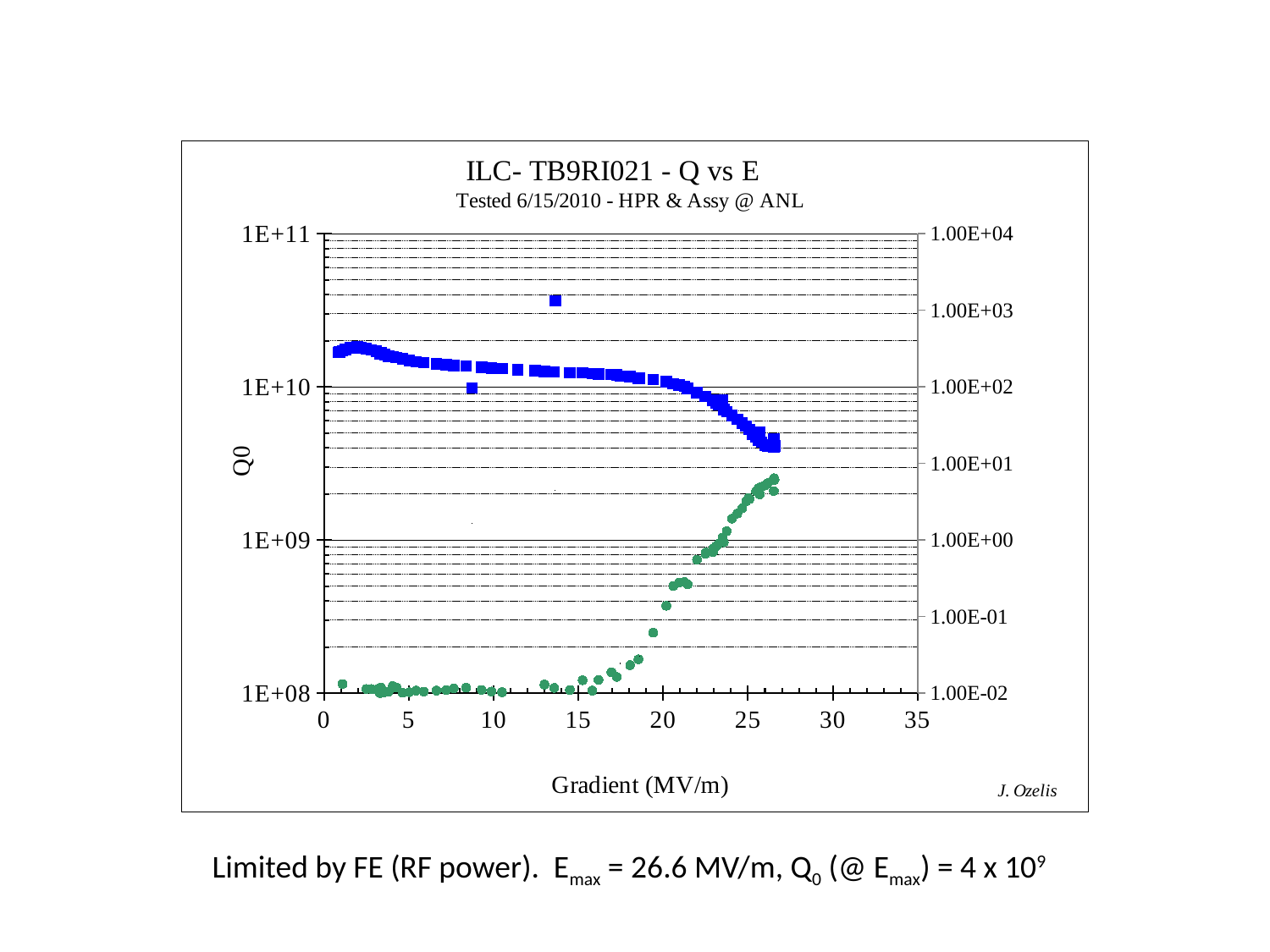
Do the blue square points rise or fall as the gradient increases along the x axis? Fall What is the title of the chart? ILC- TB9RI021 - Q vs E Which series has the higher value on the left Q0 axis at a gradient of 20 MV/m, the blue squares or the green circles? Blue squares What is the highest tick value shown on the x axis? 35 Is the Q0 value of the blue series at a gradient of 5 MV/m greater or less than 1E+10? greater Is the Q0 value of the blue series at a gradient of 25 MV/m greater or less than 1E+10? less What kind of chart is shown on the slide? Scatter chart Is the Q0 value of the blue series at a gradient of 25 MV/m greater or less than 1E+09? greater What is the label of the x axis? Gradient (MV/m) Do the green circle points rise or fall as the gradient increases from 15 to 25 MV/m? Rise How many data series are plotted on the chart? 2